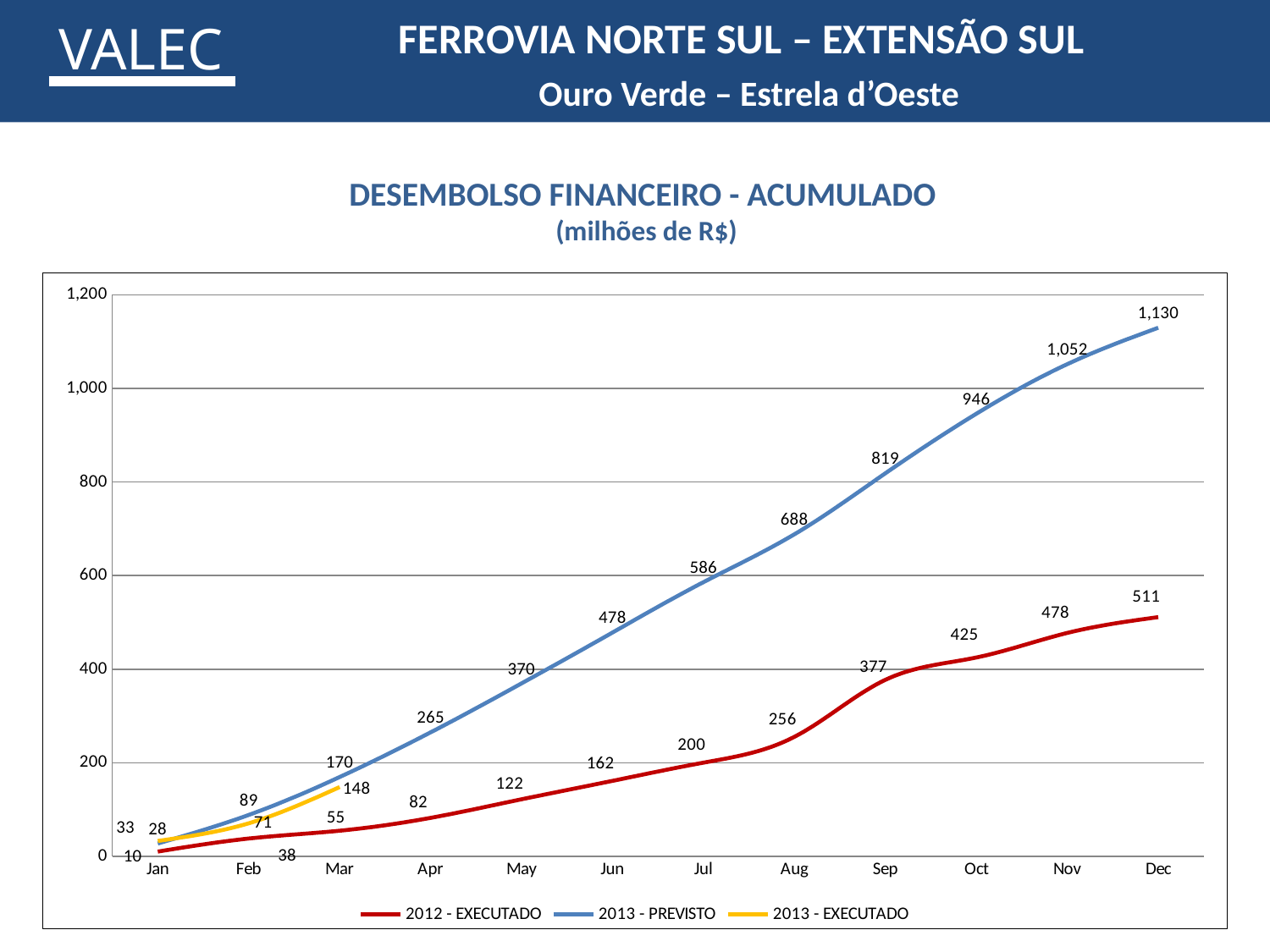
What is the value for 2012 - EXECUTADO in Dec? 511 What kind of chart is shown on the slide? line chart What is the value for 2012 - EXECUTADO in Sep? 377 How many months are shown on the x axis? 12 Does the 2012 - EXECUTADO line rise or fall from Jan to Dec? rise What is the difference between 2013 - PREVISTO and 2013 - EXECUTADO in Mar? 22 How many series does the legend list? 3 What is the difference between 2013 - PREVISTO and 2012 - EXECUTADO in Dec? 619 What is the value for 2013 - EXECUTADO in Mar? 148 In Mar, which is larger: 2013 - PREVISTO or 2013 - EXECUTADO? 2013 - PREVISTO What is the value for 2013 - PREVISTO in Dec? 1,130 What is the value for 2013 - PREVISTO in Jul? 586